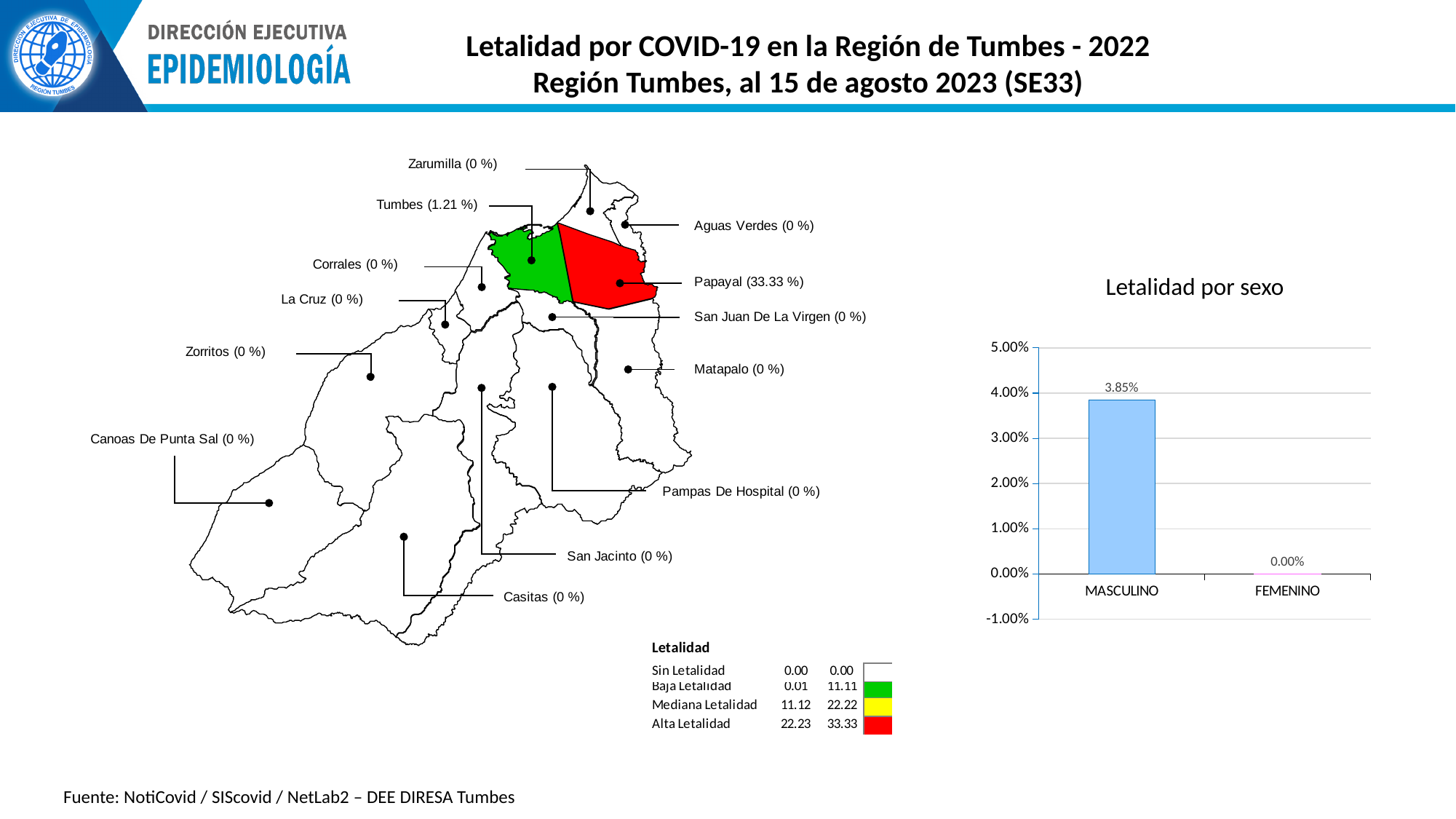
On the map on the left, what is the lethality value shown for Tumbes? 1.21 % In the 'Letalidad por sexo' chart, is the value for MASCULINO greater or less than 3.00%? greater In the 'Letalidad por sexo' chart, what is the value for FEMENINO? 0.00% In the 'Letalidad por sexo' chart, which category has the lowest value? FEMENINO What kind of chart is 'Letalidad por sexo'? bar chart What is the title of the chart on the right side of the slide? Letalidad por sexo In the 'Letalidad por sexo' chart, which category has the highest value? MASCULINO In the 'Letalidad por sexo' chart, what is the difference between the MASCULINO and FEMENINO values? 3.85% How many categories are shown in the 'Letalidad por sexo' chart? 2 On the map on the left, what is the lethality value shown for Papayal? 33.33 % In the 'Letalidad por sexo' chart, what is the value for MASCULINO? 3.85% On the map on the left, which district is shaded red? Papayal